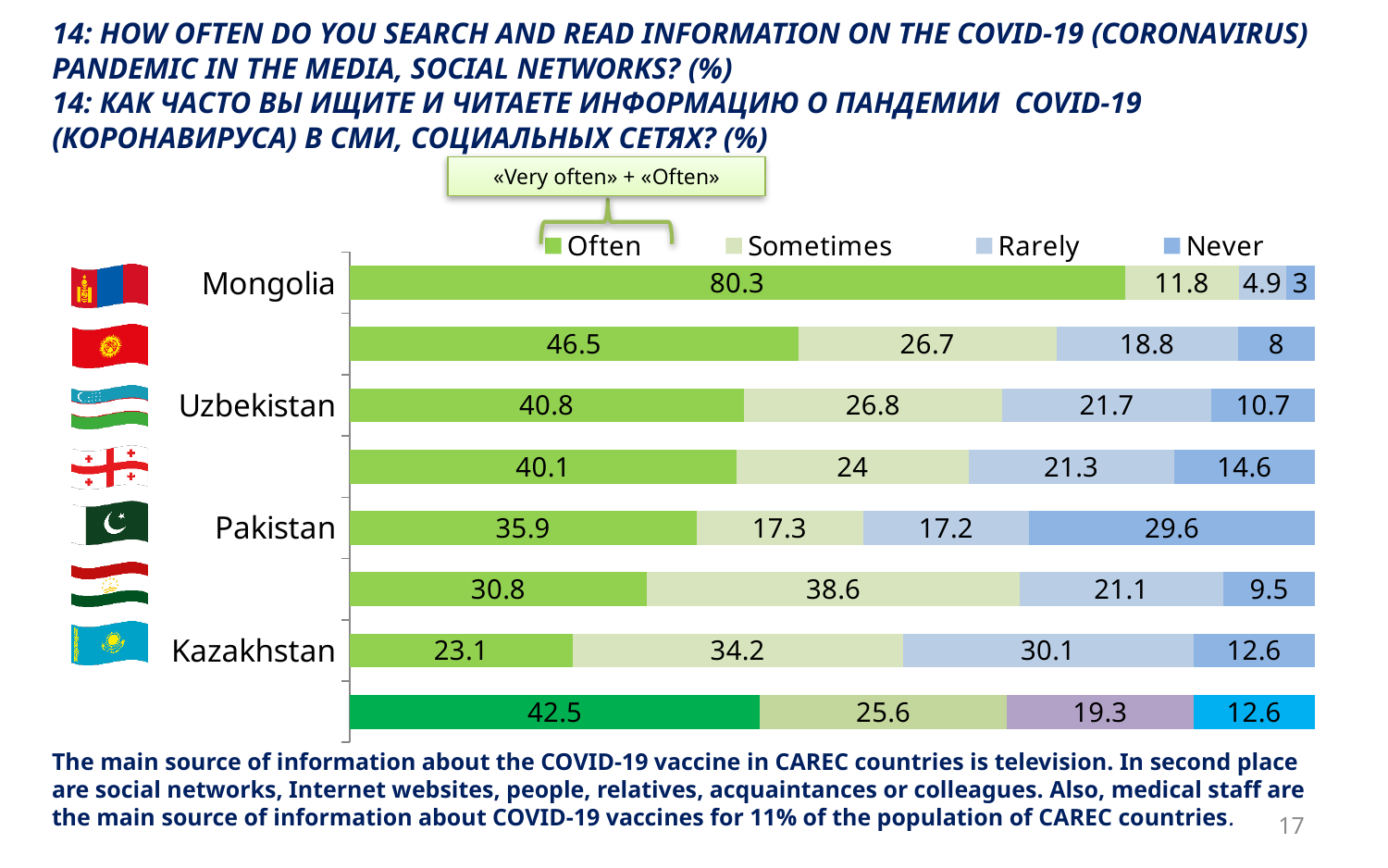
Which country has the lowest 'Often' value? Kazakhstan What kind of chart is shown on the slide? Stacked bar chart What is the 'Never' value for Pakistan? 29.6 What is the difference between the 'Often' values for Mongolia and Kazakhstan? 57.2 What is the total of the stacked bar for Uzbekistan? 100 What is the 'Often' value for Mongolia? 80.3 What is the 'Rarely' value for Uzbekistan? 21.7 What is the difference between the 'Never' values for Pakistan and Uzbekistan? 18.9 For Kazakhstan, which is larger: the 'Sometimes' value or the 'Rarely' value? Sometimes Which country has the highest 'Often' value? Mongolia What is the 'Sometimes' value for Kazakhstan? 34.2 How many series does the legend list? 4